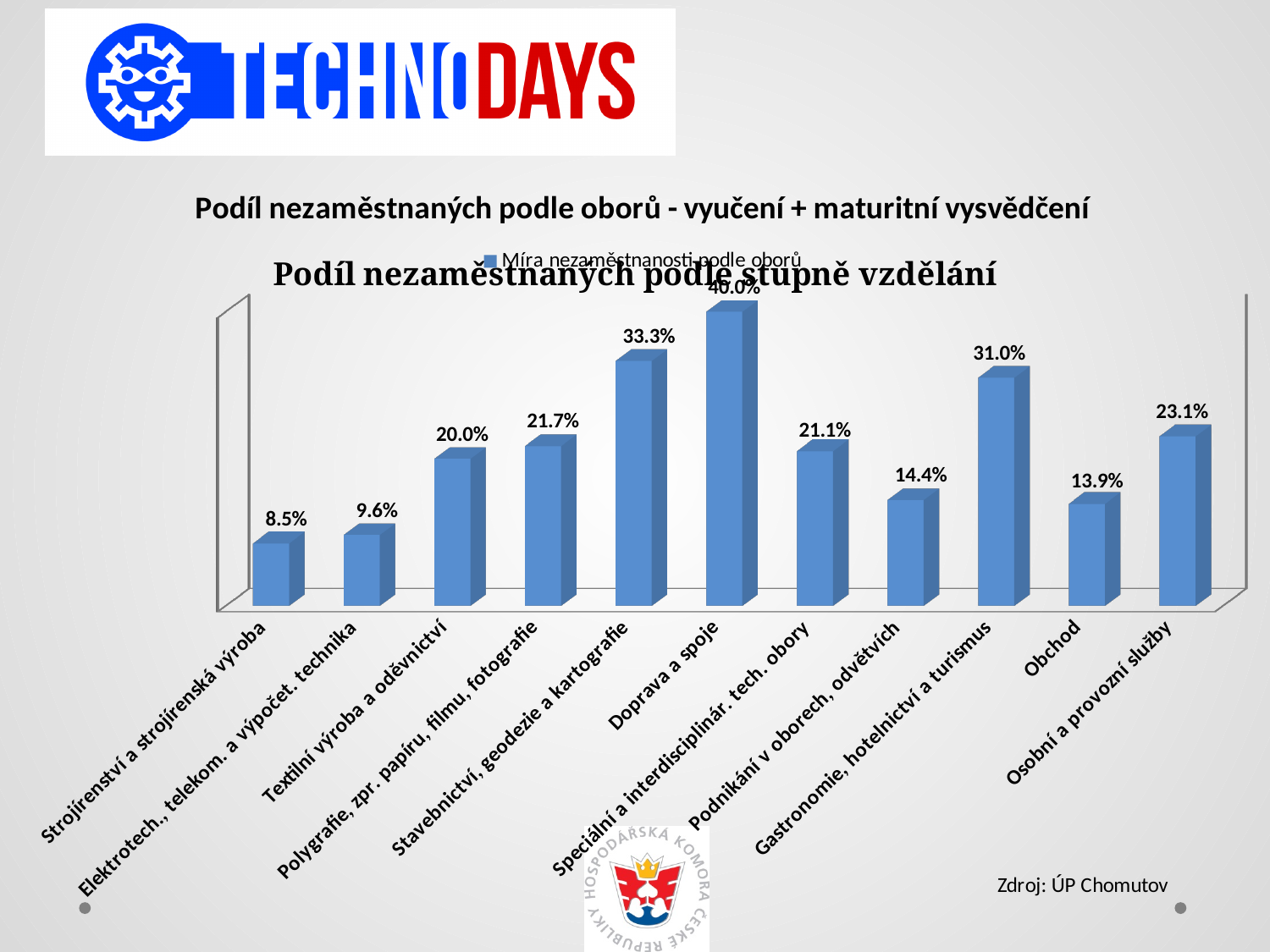
Which category has the lowest value? Strojírenství a strojírenská výroba How many series does the legend list? 1 Which category has the highest value? Doprava a spoje What is the value for Obchod? 13.9% What is the value for Doprava a spoje? 40.0% How many categories are shown in the chart? 11 What is the difference between the values for Osobní a provozní služby and Podnikání v oborech, odvětvích? 8.7% What is the legend entry of the chart? Míra nezaměstnanosti podle oborů What kind of chart is shown on the slide? Bar chart What is the value for Gastronomie, hotelnictví a turismus? 31.0% Which is larger, the value for Polygrafie, zpr. papíru, filmu, fotografie or the value for Speciální a interdisciplinár. tech. obory? Polygrafie, zpr. papíru, filmu, fotografie What is the difference between the values for Stavebnictví, geodezie a kartografie and Textilní výroba a oděvnictví? 13.3%